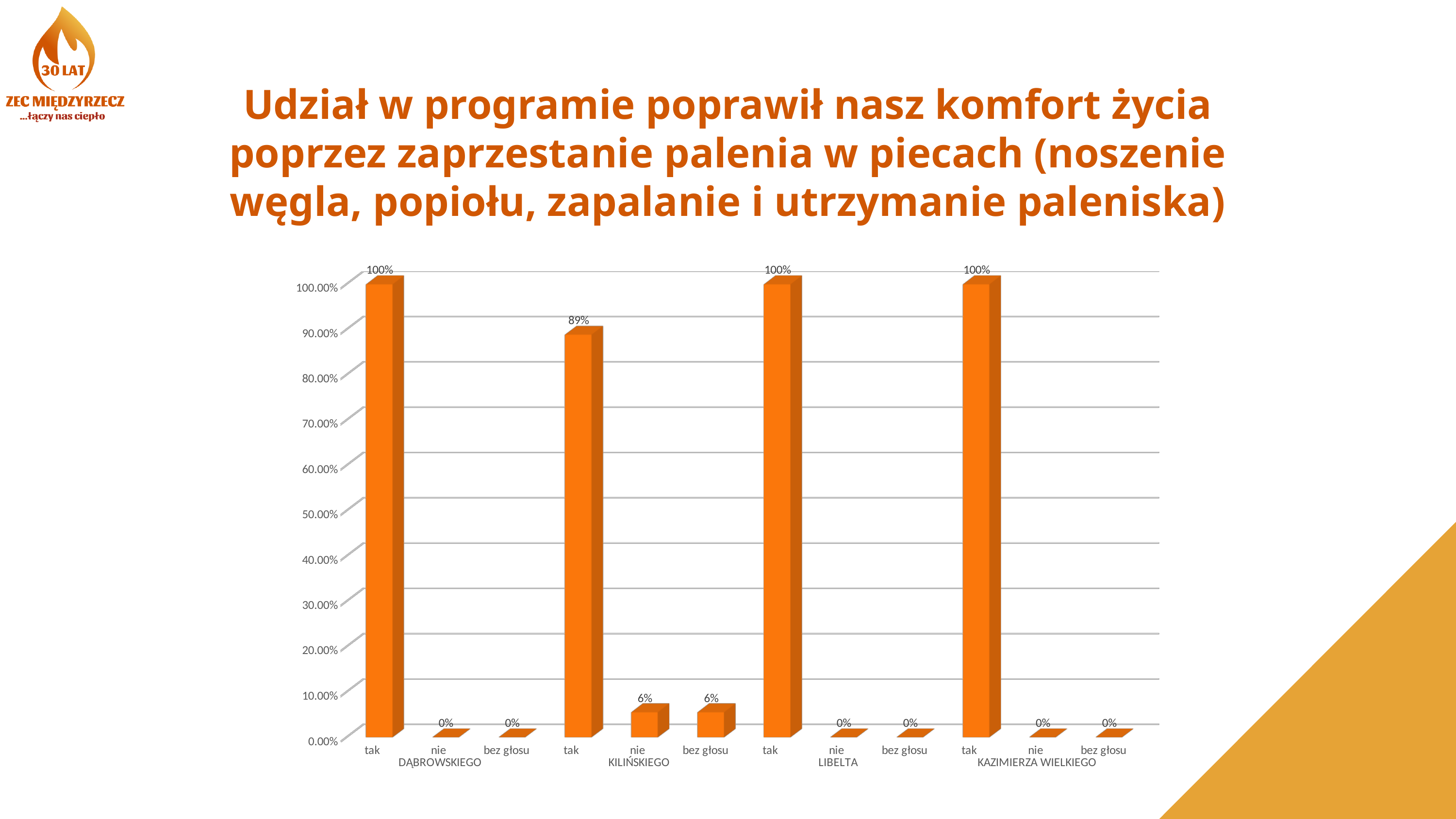
What is the value for "tak" in the KILIŃSKIEGO group? 89% How many street groups are shown on the x axis? 4 Is the value for "tak" in the KILIŃSKIEGO group greater or less than 80.00%? greater What kind of chart is shown on the slide? bar chart Which is larger: the "tak" value for KILIŃSKIEGO or the "tak" value for LIBELTA? LIBELTA What is the difference between the "nie" and "bez głosu" values in the KILIŃSKIEGO group? 0% Which group has the lowest value for "tak"? KILIŃSKIEGO What is the difference between the "tak" value for DĄBROWSKIEGO and the "tak" value for KILIŃSKIEGO? 11% How many bars are plotted in total on the chart? 12 What is the value for "nie" in the KILIŃSKIEGO group? 6% What is the value for "tak" in the LIBELTA group? 100% What is the value for "bez głosu" in the KAZIMIERZA WIELKIEGO group? 0%